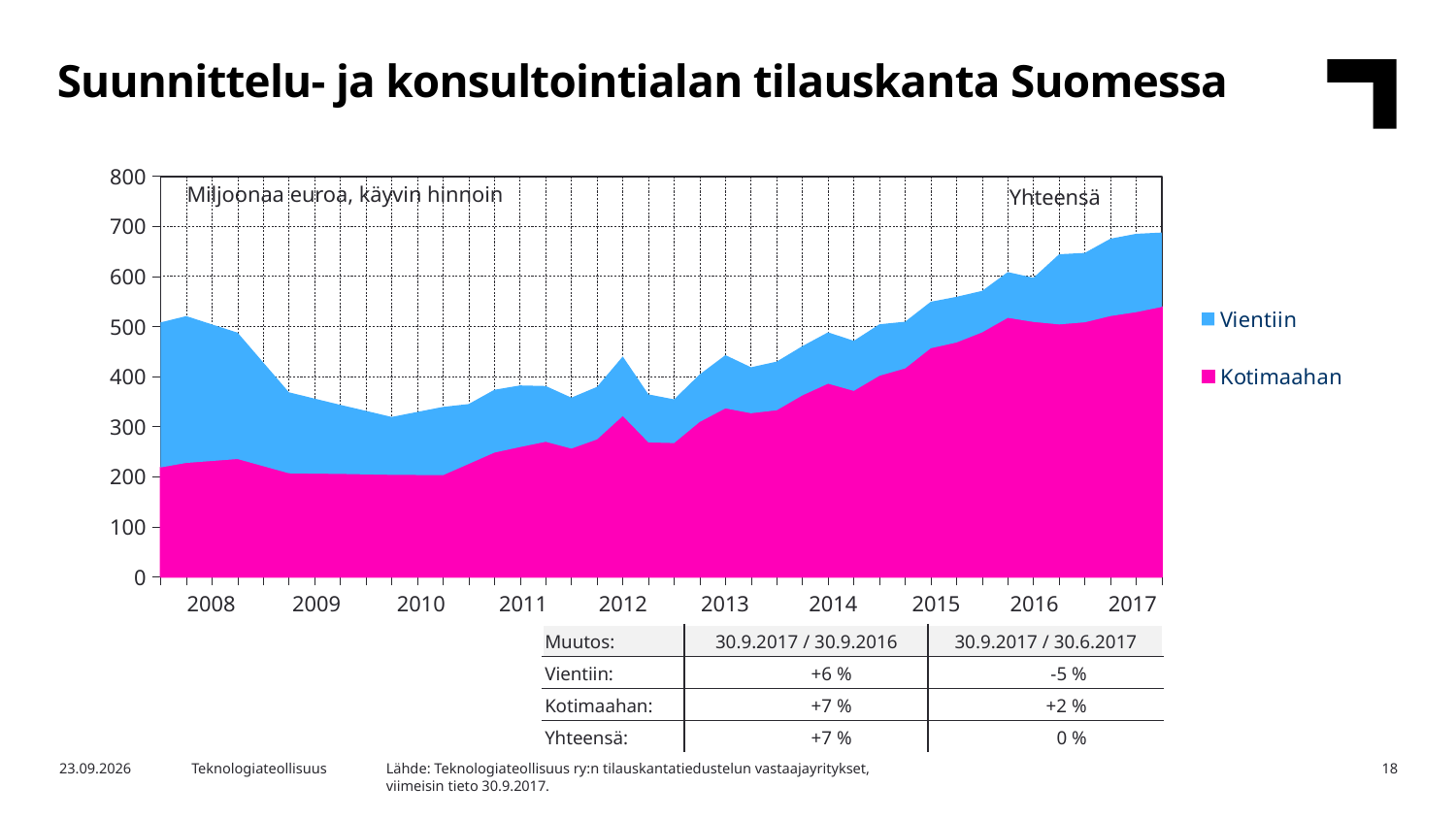
How many year labels are shown on the x axis of the chart? 10 Does the Kotimaahan series rise or fall between 2010 and 2017? rise Is the total (Yhteensä) around 2010 greater or less than 400? less Is the total (Yhteensä) at the end of 2017 greater or less than 600? greater Does the total (Yhteensä) rise or fall between 2008 and 2010? fall Which two series are listed in the chart legend? Vientiin and Kotimaahan According to the table below the chart, what is the change for Vientiin for 30.9.2017 / 30.9.2016? +6 % Is the value for Kotimaahan around 2010 greater or less than 300? less What unit is stated in the text at the top left of the chart area? Miljoonaa euroa, käyvin hinnoin How many series does the chart legend list? 2 What kind of chart is shown on the slide? Stacked area chart